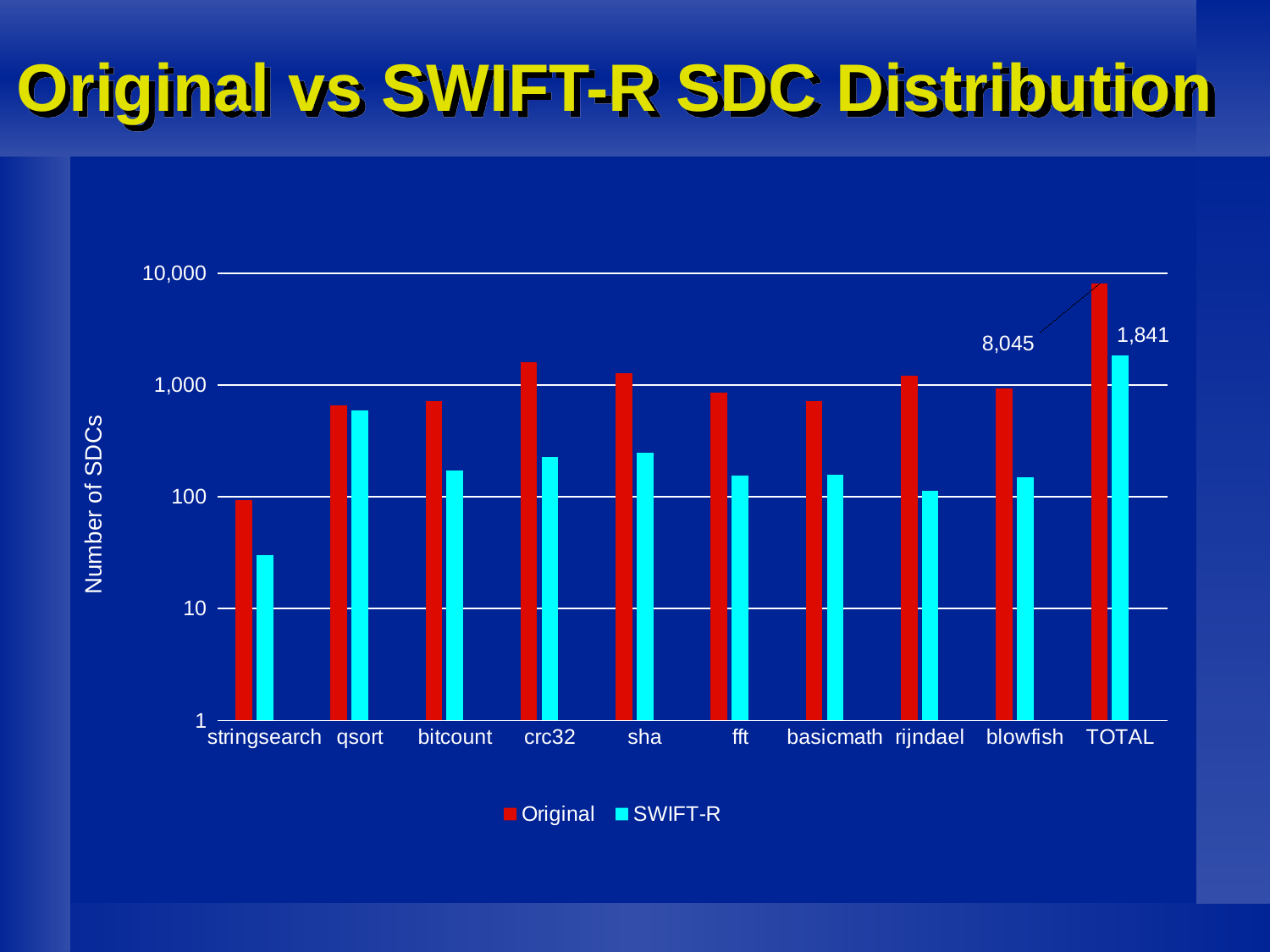
How many categories are shown on the x axis? 10 How many series does the legend list? 2 Which category has the lowest Original value? stringsearch What is the value for TOTAL in the Original series? 8,045 For TOTAL, which series has the larger value, Original or SWIFT-R? Original Is the Original value for crc32 greater or less than 1,000? greater Is the SWIFT-R value for stringsearch greater or less than 100? less What is the difference between the Original and SWIFT-R values for TOTAL? 6,204 Which category has the highest SWIFT-R value? TOTAL What is the title of the y axis? Number of SDCs For bitcount, which series has the larger value, Original or SWIFT-R? Original What is the value for TOTAL in the SWIFT-R series? 1,841